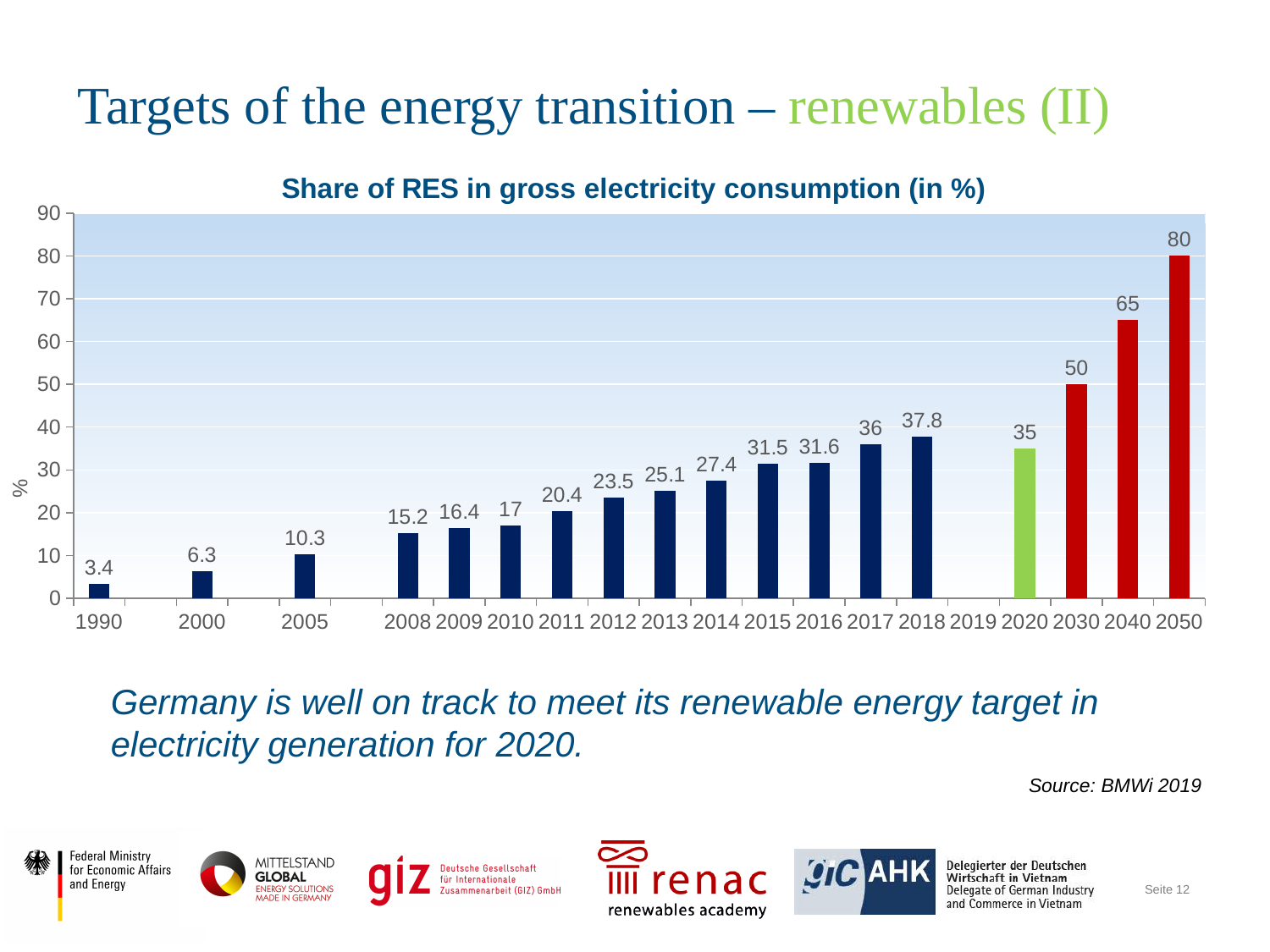
What is the title of the chart? Share of RES in gross electricity consumption (in %) Which year has the lowest value in the chart? 1990 What is the target value shown for 2050? 80 Which is larger, the value for 2018 or the value for 2020? 2018 What is the difference between the values for 2040 and 2030? 15 What is the share of RES in gross electricity consumption for 2018? 37.8 Which year has the highest value in the chart? 2050 What kind of chart is shown on the slide? bar chart What value is shown for 1990? 3.4 What is the difference between the values for 2018 and 2017? 1.8 What value is shown for 2020? 35 Do the values generally rise or fall from 1990 to 2018? rise